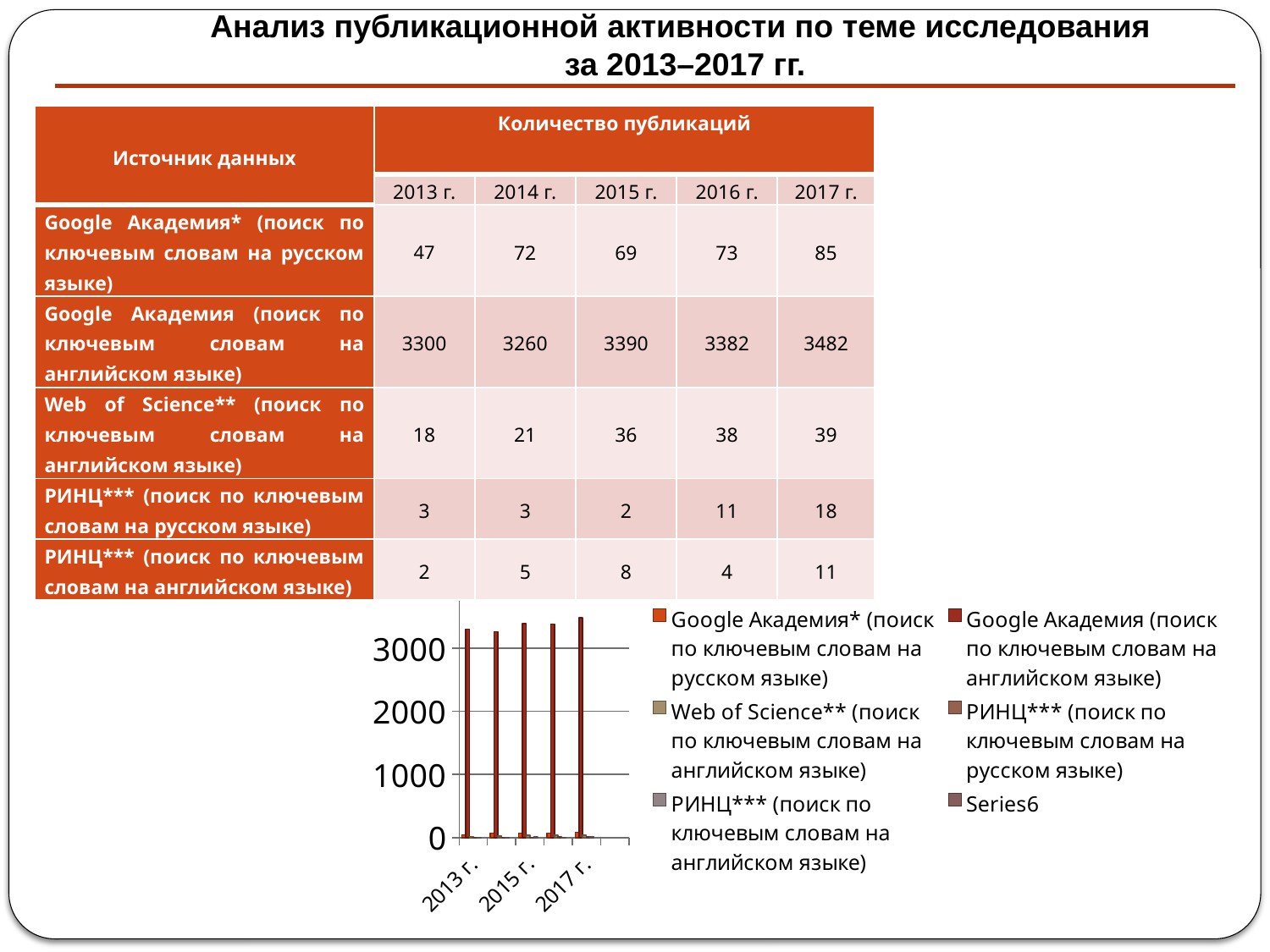
Do the values for Web of Science** (поиск по ключевым словам на английском языке) rise or fall from 2013 г. to 2017 г.? rise Which is larger for Web of Science** (поиск по ключевым словам на английском языке): the value in 2015 г. or in 2014 г.? 2015 г. How many year categories are plotted along the x axis of the chart? 5 Is the tallest bar for 2013 г. greater or less than 3000? greater What kind of chart is shown at the bottom of the slide? bar chart What is the value for Google Академия* (поиск по ключевым словам на русском языке) in 2013 г.? 47 What is the difference between the 2017 г. and 2013 г. values for Google Академия (поиск по ключевым словам на английском языке)? 182 Is the bar for Web of Science** in 2017 г. greater or less than 1000? less Which series has the tallest bars in the chart? Google Академия (поиск по ключевым словам на английском языке) In which year is the value for Google Академия (поиск по ключевым словам на английском языке) the lowest? 2014 г. What is the value for Google Академия (поиск по ключевым словам на английском языке) in 2017 г.? 3482 How many series does the chart legend list? 6